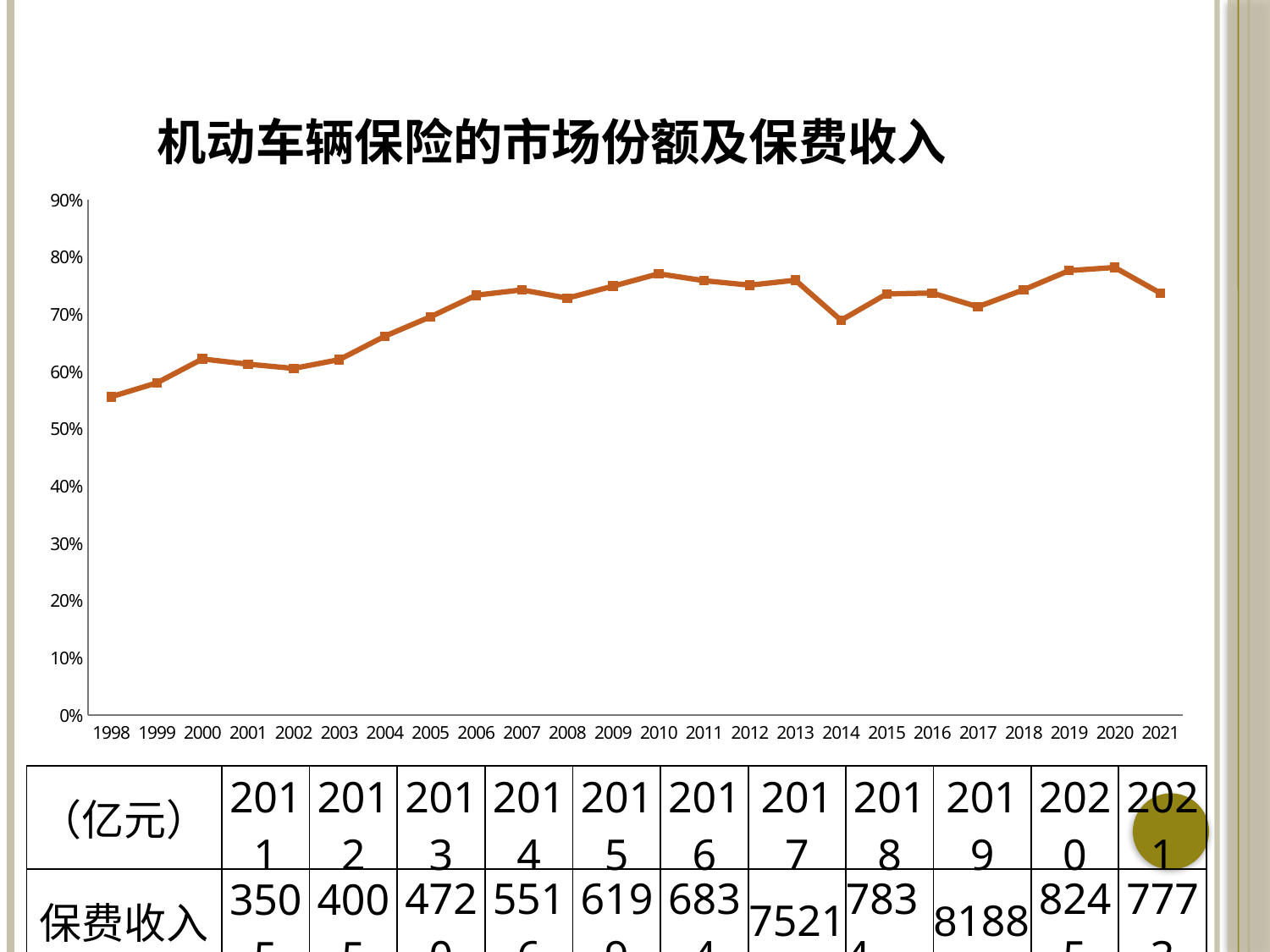
Is the value for 2006 greater or less than 70%? greater Is the value for 2002 greater or less than 50%? greater Is the value for 1998 greater or less than 60%? less Which year has the lowest market share value in the chart? 1998 Which is larger, the value for 1998 or the value for 2021? 2021 Which is larger, the value for 2010 or the value for 2014? 2010 Does the market share generally rise or fall from 1998 to 2010? rise What kind of chart is shown on the slide? line chart What is the title of the chart? 机动车辆保险的市场份额及保费收入 How many years are plotted along the x axis of the chart? 24